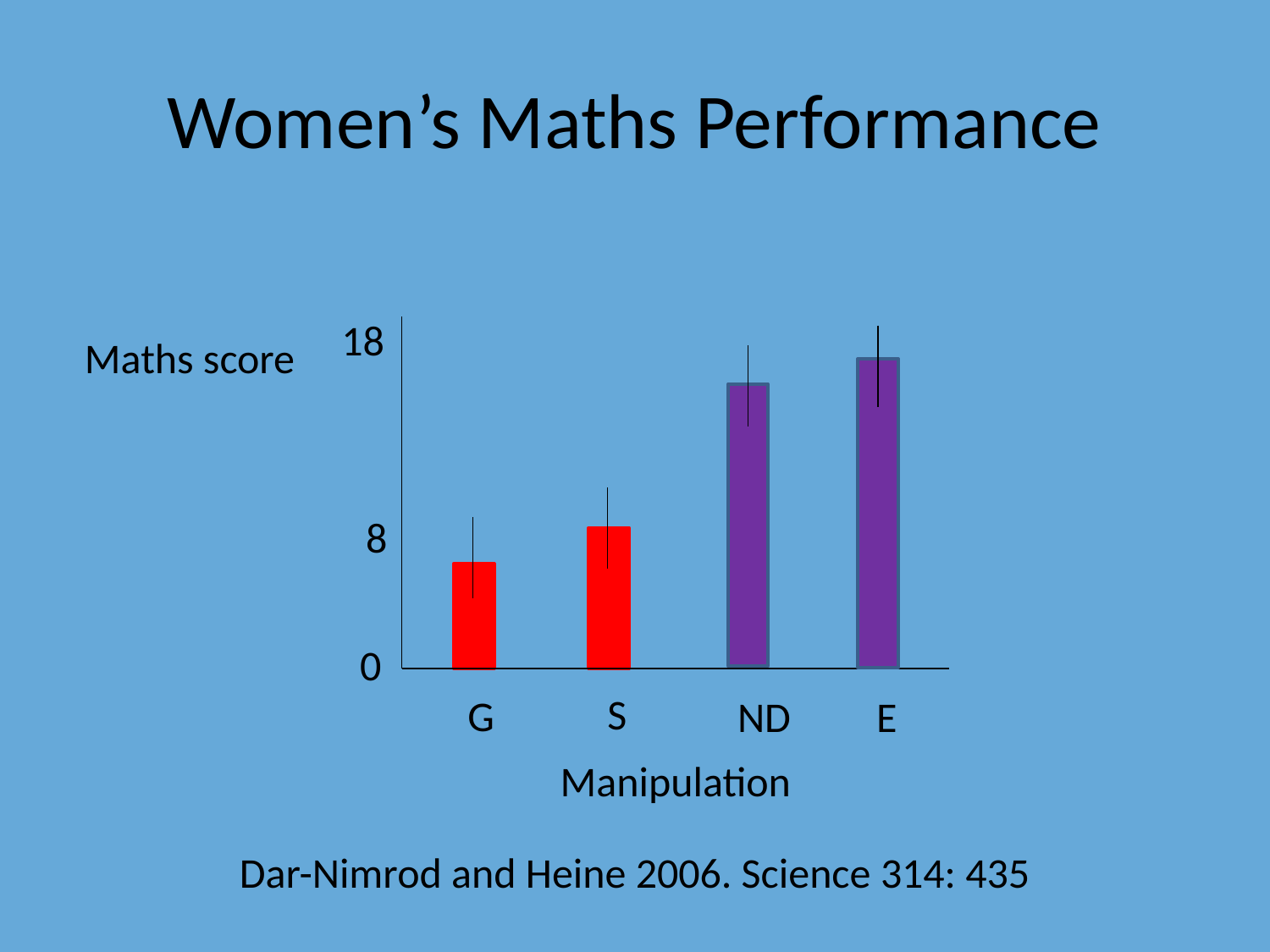
Which has the larger maths score, G or ND? ND Which manipulation has the highest maths score? E How many categories are shown on the x axis of the chart? 4 Do the maths scores rise or fall from G to E along the x axis? rise Is the maths score for E greater or less than 8? greater What is the title of the chart? Women's Maths Performance Which has the larger maths score, S or E? E Is the maths score for G greater or less than 8? less Which manipulation has the lowest maths score? G Is the maths score for ND greater or less than 8? greater What kind of chart is shown on the slide? bar chart